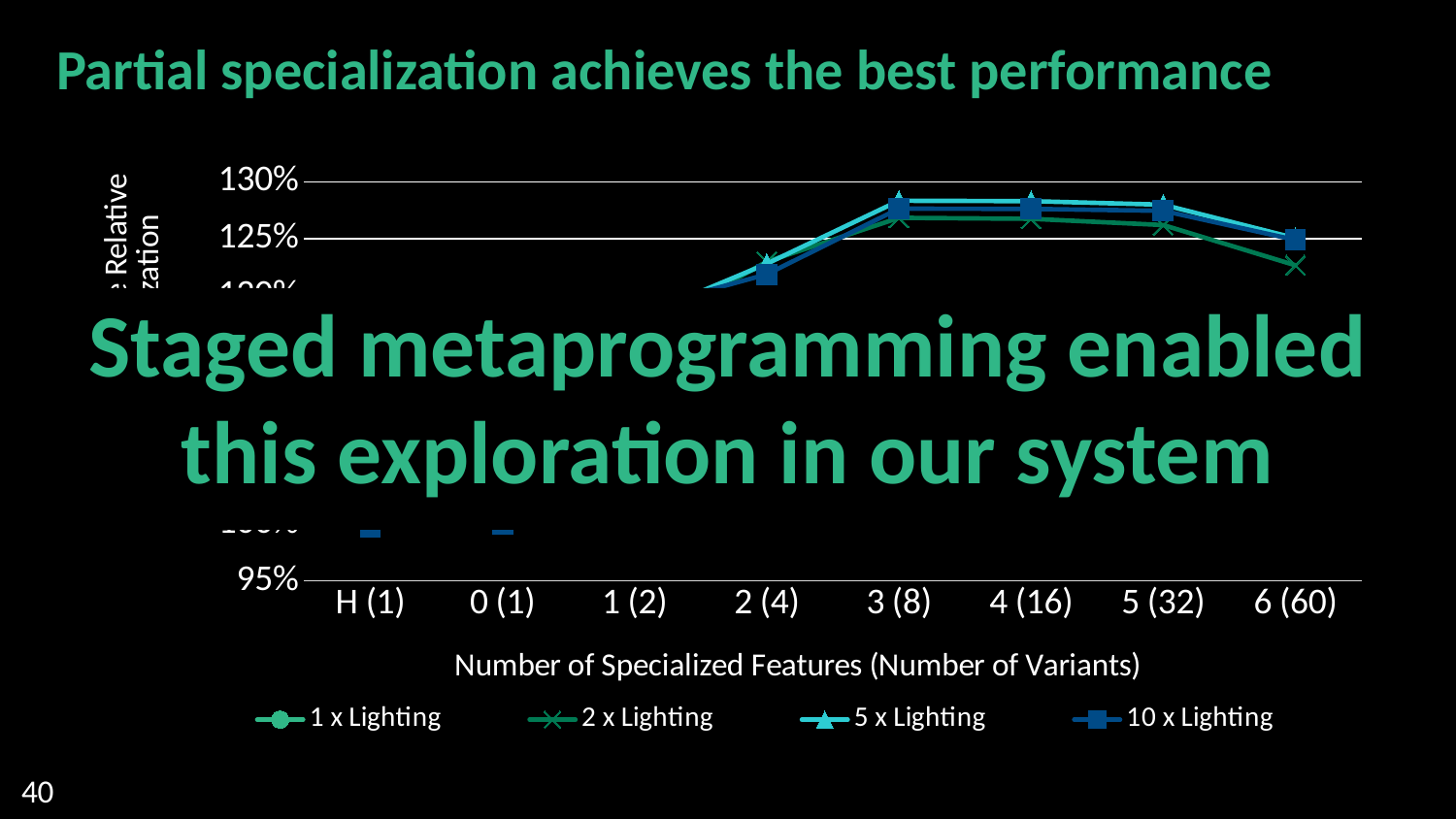
Is the value for 5 x Lighting at 3 (8) greater or less than 125%? greater Which series in the legend is drawn with triangle markers? 5 x Lighting What kind of chart is shown on the slide? line chart At 6 (60), which series has the higher value: 10 x Lighting or 2 x Lighting? 10 x Lighting Is the value for 2 x Lighting at 6 (60) greater or less than 125%? less How many categories are shown on the x axis of the chart? 8 What is the highest tick label shown on the y axis of the chart? 130% Is the value for 10 x Lighting at 2 (4) greater or less than 125%? less What is the title of the x axis of the chart? Number of Specialized Features (Number of Variants) How many series does the chart legend list? 4 Does the 2 x Lighting series rise or fall from 5 (32) to 6 (60)? fall